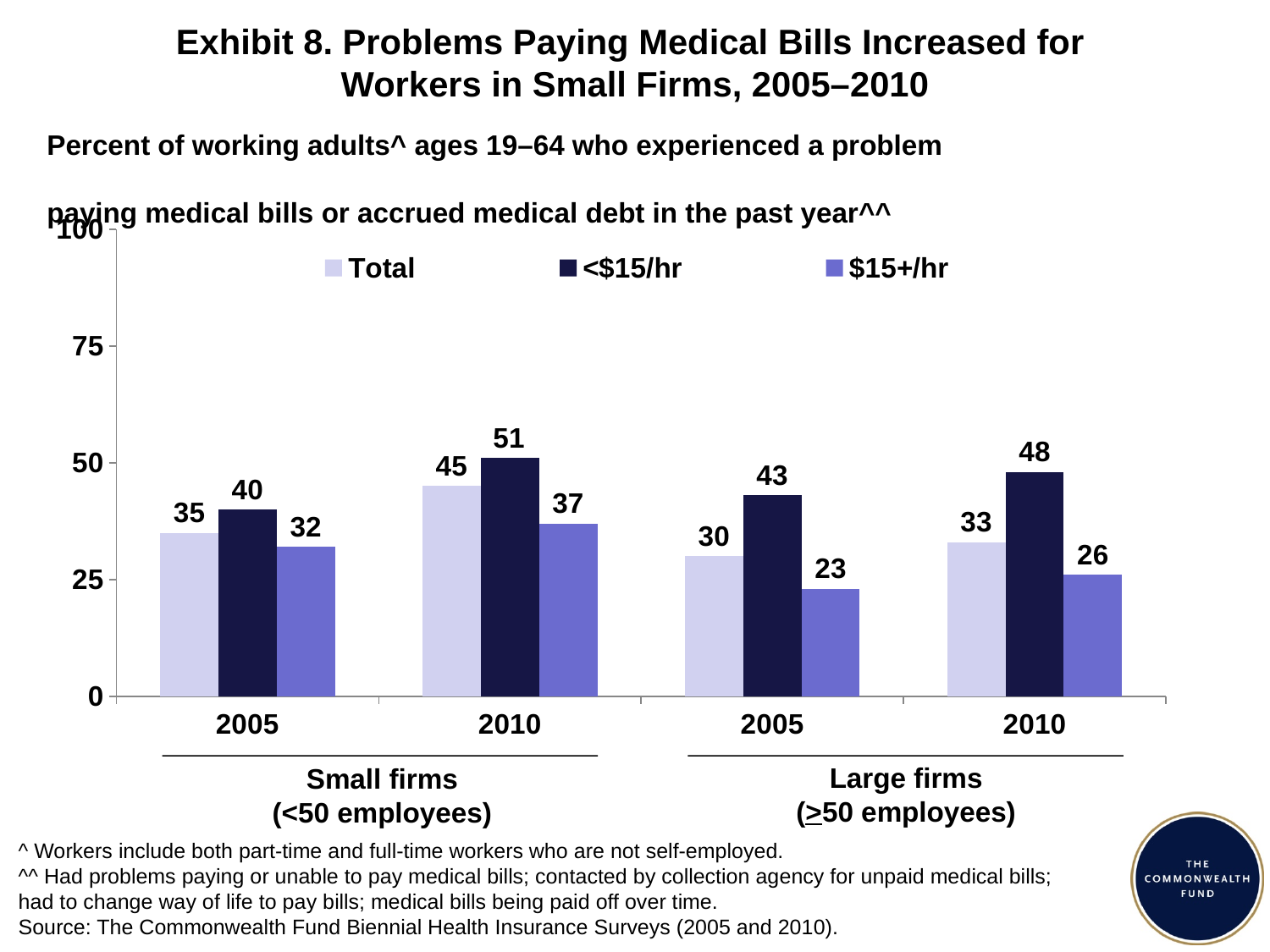
Which group has the lowest value on the chart? $15+/hr, large firms, 2005 What is the value for $15+/hr workers in large firms in 2010? 26 Which group has the highest value on the chart? <$15/hr, small firms, 2010 What is the value for <$15/hr workers in small firms in 2010? 51 By how much did the Total value for small firms change from 2005 to 2010? 10 What is the difference between the <$15/hr and $15+/hr values for large firms in 2005? 20 What kind of chart is shown on the slide? Bar chart Did the Total value for large firms rise or fall from 2005 to 2010? Rise What is the Total value for large firms in 2005? 30 Is the value for <$15/hr workers in large firms in 2010 greater or less than 50? less Which is larger: the Total value for small firms in 2010 or the Total value for large firms in 2010? Small firms in 2010 How many series does the legend list? 3